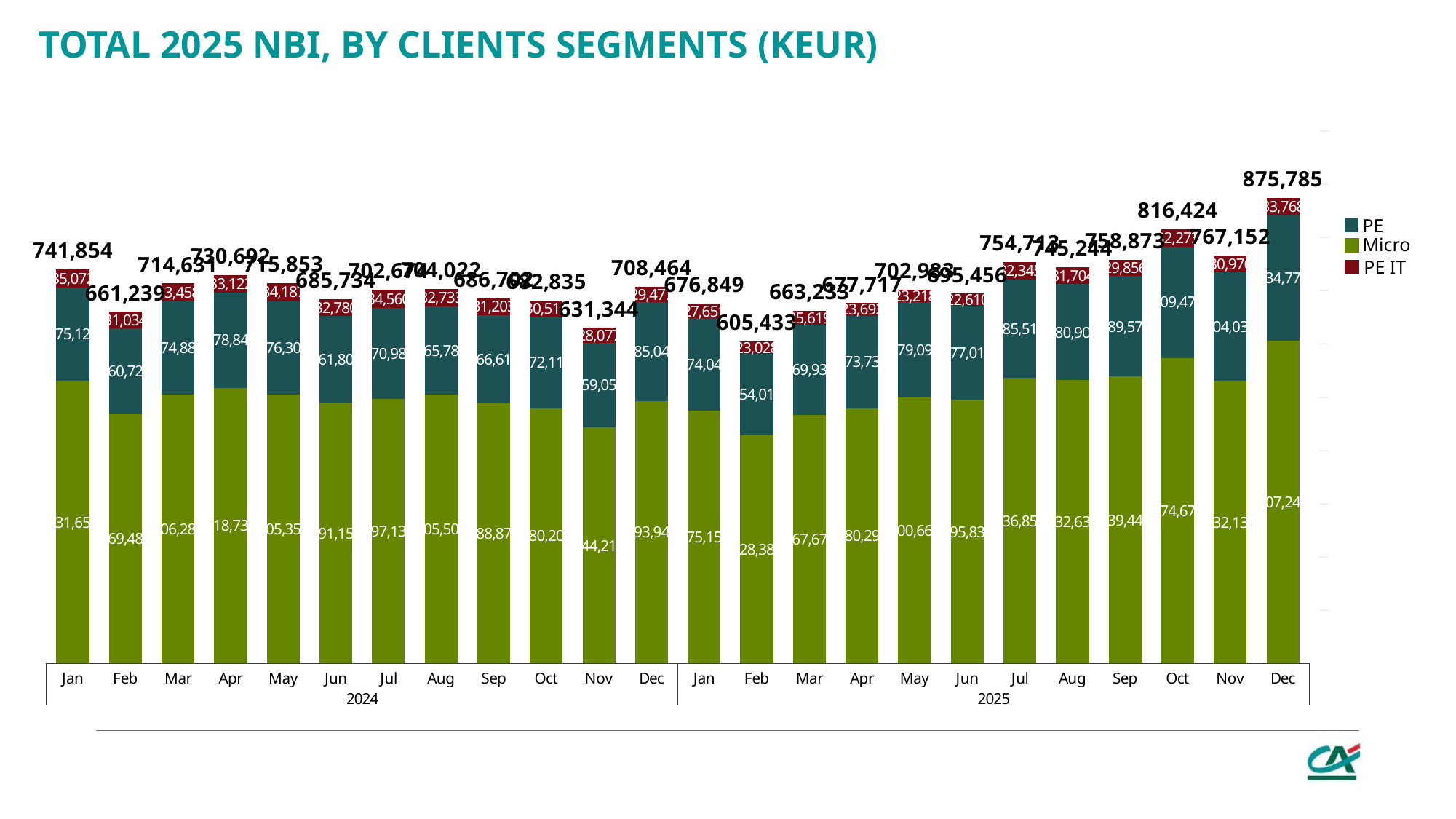
What is the difference between the total NBI for Dec 2025 and Oct 2025? 59,361 Which month has the highest total NBI? Dec 2025 Which month has the lowest total NBI? Feb 2025 How many series does the legend list? 3 What is the total NBI for Oct 2025? 816,424 What is the total NBI for Feb 2025? 605,433 Which client segment makes up the largest part of each bar? Micro How many monthly bars are shown in the chart? 24 What is the total NBI for Dec 2025? 875,785 What kind of chart is shown on the slide? Stacked bar chart What is the total NBI for Jan 2024? 741,854 Which is larger, the total NBI for Jan 2024 or Dec 2024? Jan 2024